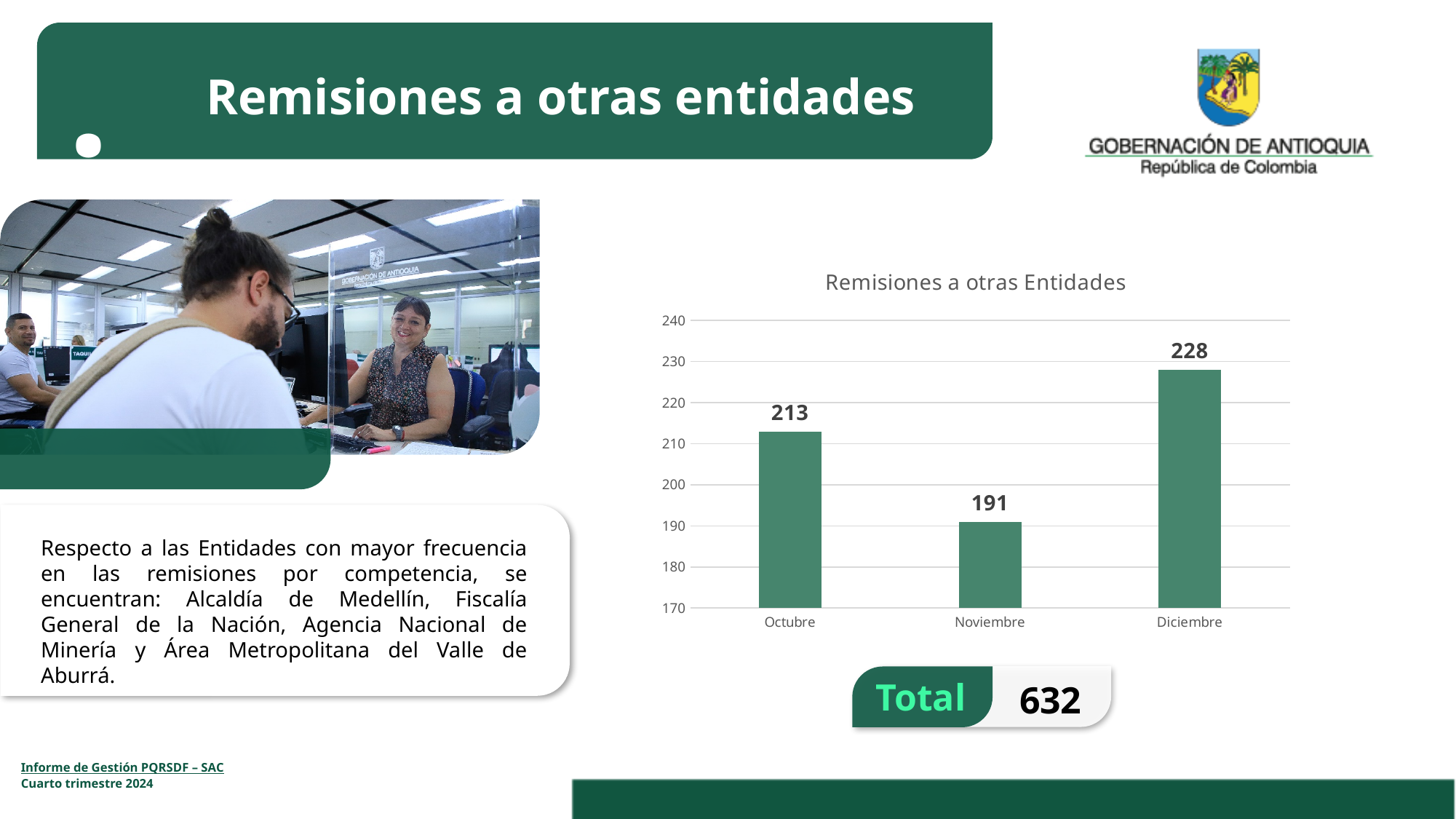
What is the value for Octubre? 213 How many months are shown on the chart? 3 What kind of chart is shown on the slide? bar chart Which month has the lowest value? Noviembre Which is larger, the value for Octubre or the value for Diciembre? Diciembre What is the value for Noviembre? 191 What is the difference between the values for Diciembre and Noviembre? 37 What is the difference between the values for Octubre and Noviembre? 22 What is the value for Diciembre? 228 What is the title of the chart? Remisiones a otras Entidades Is the value for Noviembre greater or less than 200? less Which month has the highest value? Diciembre